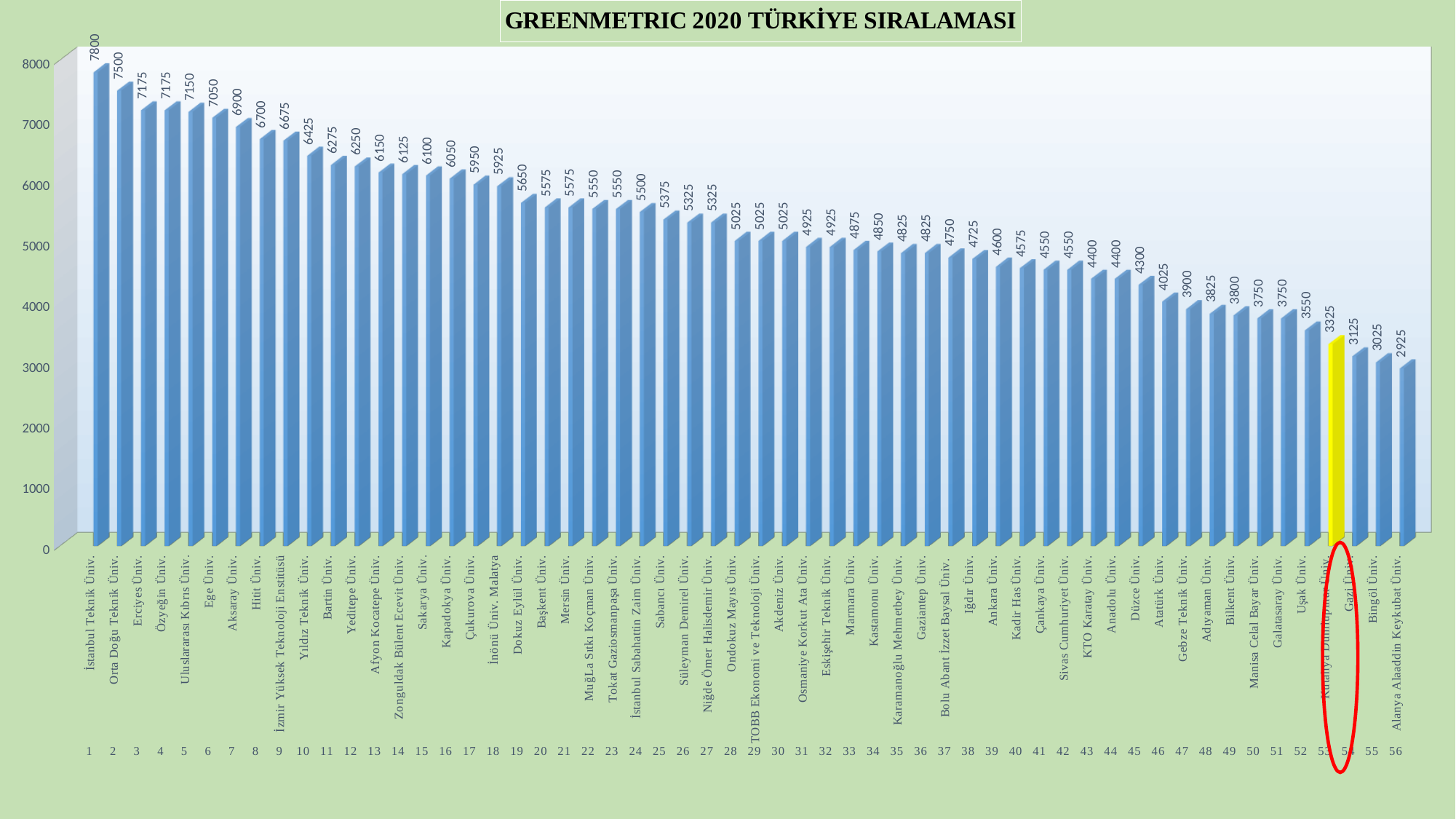
How many universities are shown in the chart? 56 What is the value for İstanbul Teknik Üniv.? 7800 What is the value for Ankara Üniv.? 4600 Is the value for Bilkent Üniv. greater or less than 4000? less Which university has the lowest value? Alanya Alaaddin Keykubat Üniv. Do the values rise or fall from left to right along the x axis? fall What is the difference between the values for İstanbul Teknik Üniv. and Orta Doğu Teknik Üniv.? 300 What is the value for Gazi Üniv.? 3125 What is the value for Sakarya Üniv.? 6100 What kind of chart is shown on the slide? bar chart Which has a larger value, Ege Üniv. or Hitit Üniv.? Ege Üniv. Which university has the highest value? İstanbul Teknik Üniv.